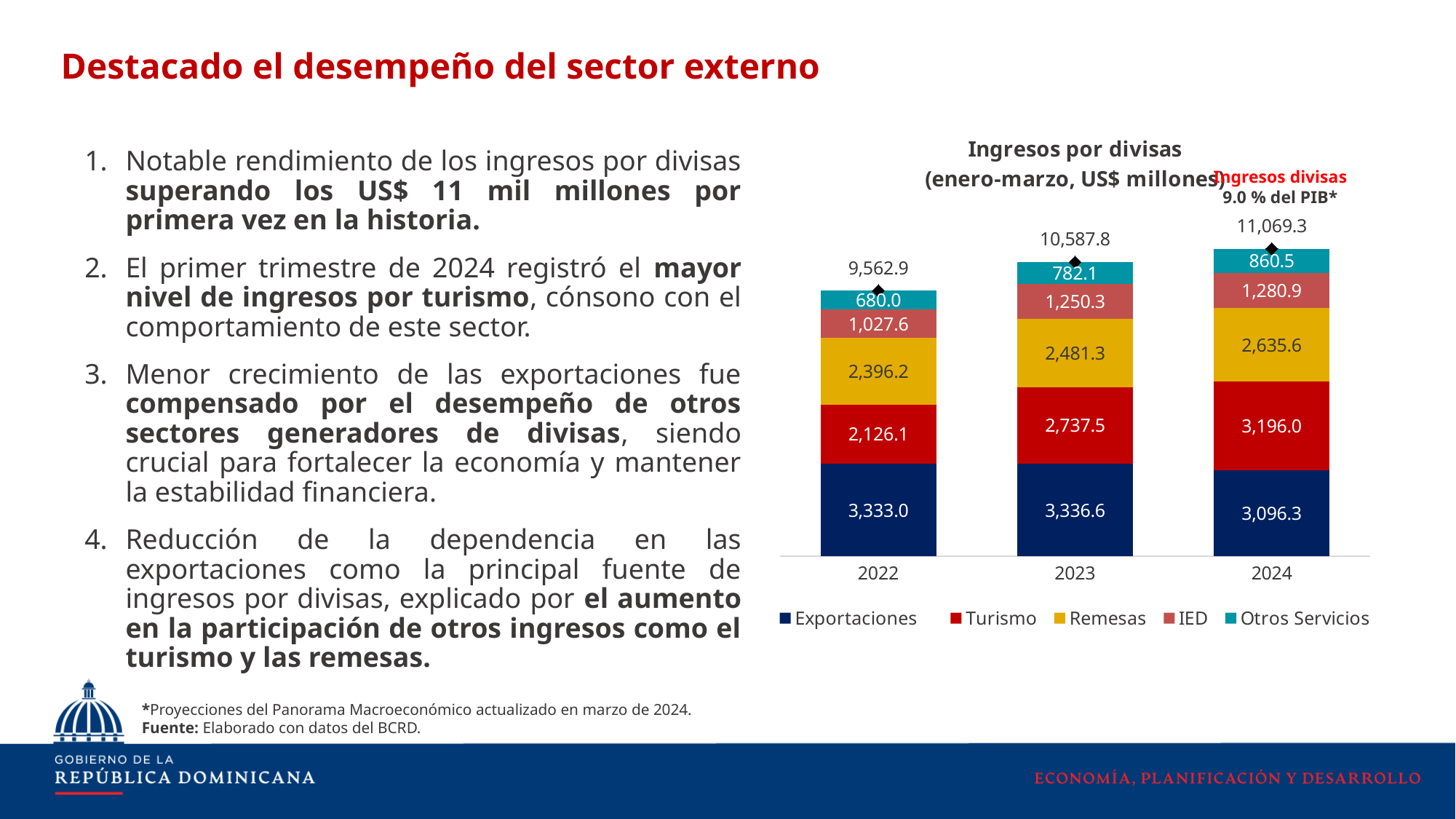
What is the total of the stacked bar for 2023? 10,587.8 How many years are shown on the x axis of the chart? 3 What is the value for Turismo in 2024? 3,196.0 What is the difference between the Turismo value in 2024 and in 2023? 458.5 What is the value for IED in 2023? 1,250.3 In which year is the value for Otros Servicios the lowest? 2022 What type of chart is shown on the slide? Stacked bar chart In 2024, which is larger: Exportaciones or Turismo? Turismo What is the title of the chart? Ingresos por divisas (enero-marzo, US$ millones) What is the value for Remesas in 2022? 2,396.2 How many series does the chart legend list? 5 Which year has the highest total ingresos por divisas? 2024